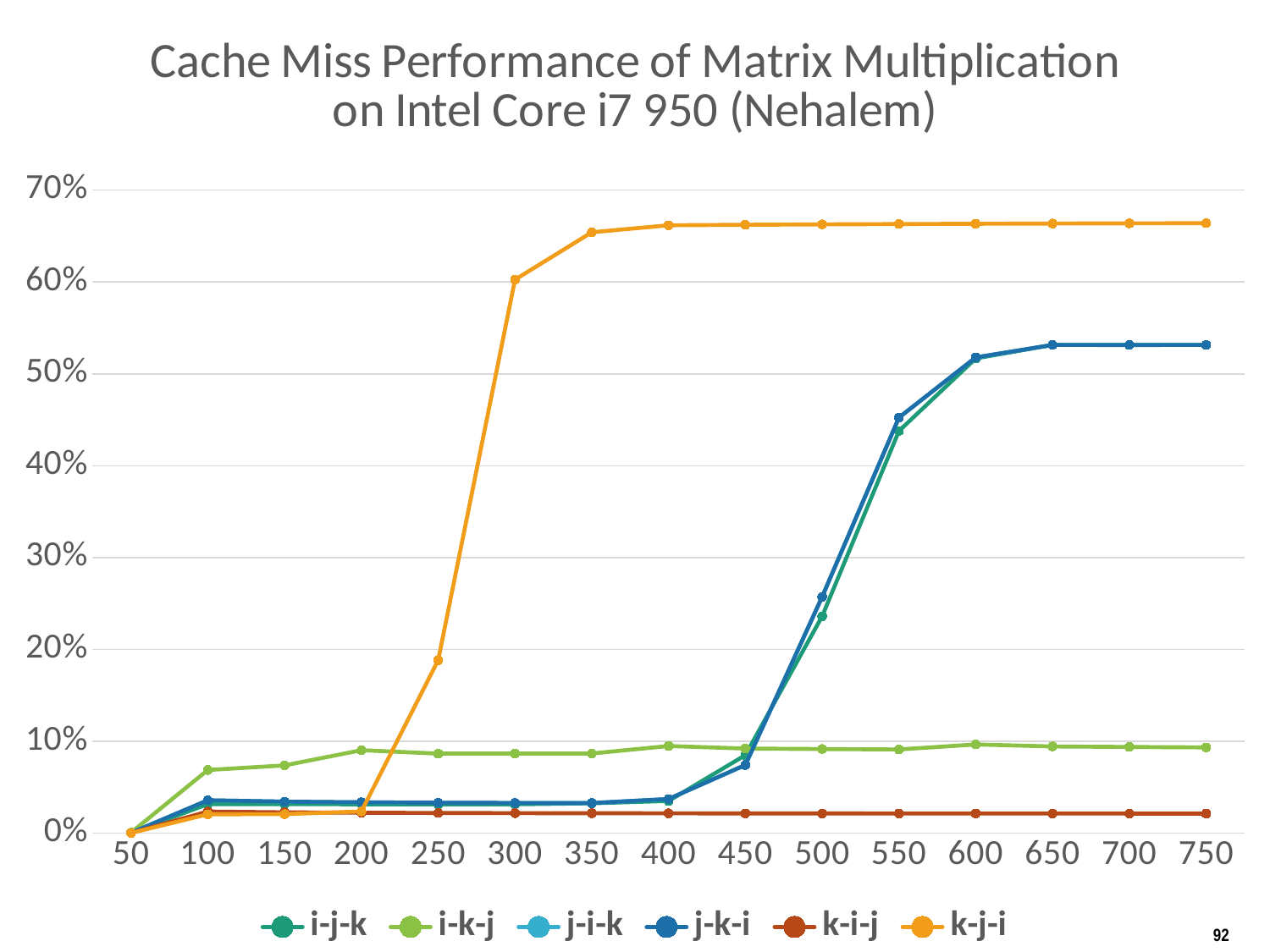
Does the k-j-i series rise or fall between 50 and 350? rise Is the value for k-j-i at 300 greater or less than 50%? greater Is the value for k-j-i at 750 greater or less than 60%? greater Is the value for j-k-i at 500 greater or less than 20%? greater What kind of chart is shown on the slide? line chart How many series does the legend list? 6 Which series has the highest cache miss rate at 750? k-j-i Which series has the lowest cache miss rate at 750? k-i-j How many x-axis points (matrix sizes) are plotted, from 50 to 750? 15 At 550, which series has the larger value, k-j-i or j-k-i? k-j-i